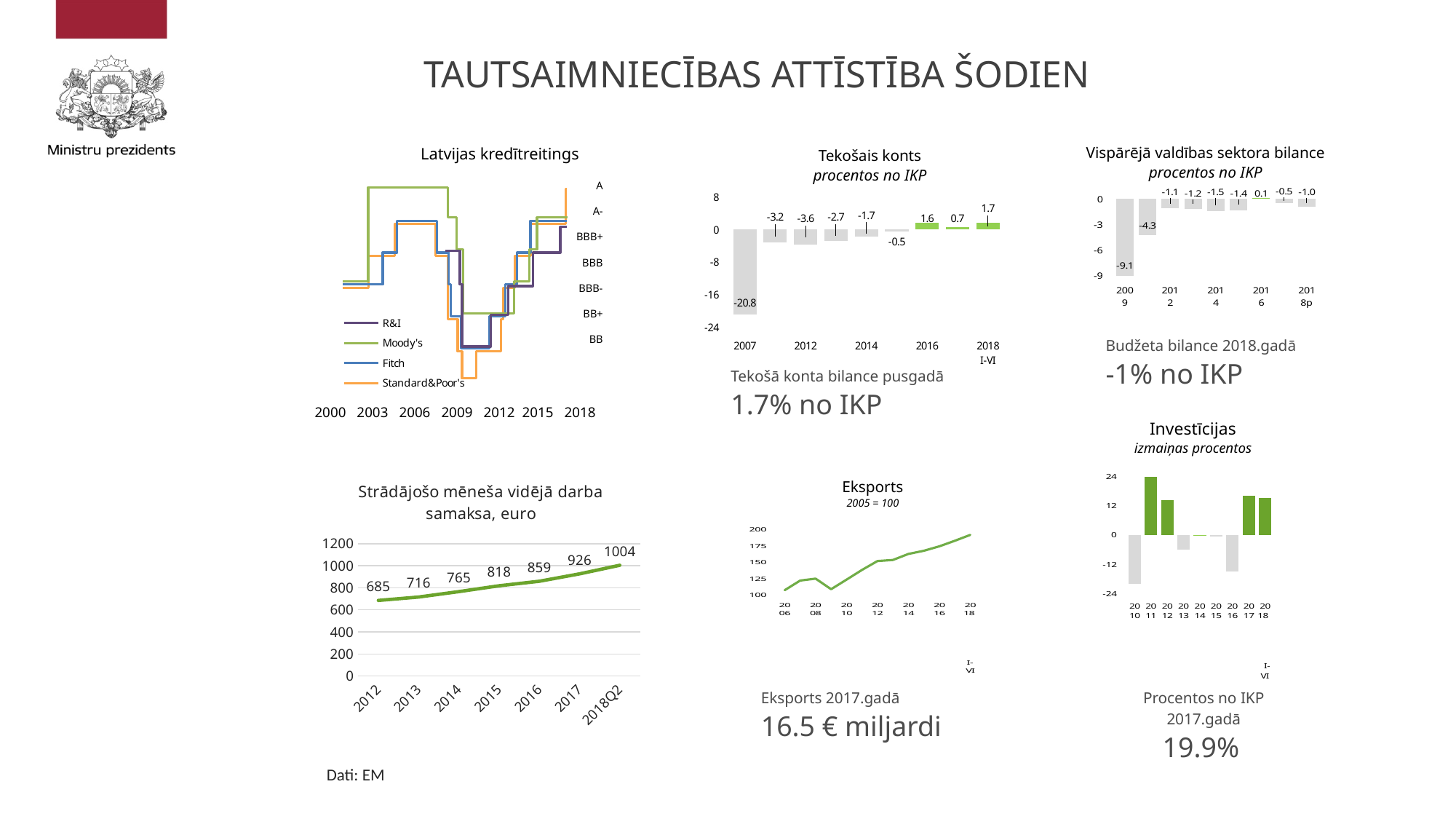
In the 'Vispārējā valdības sektora bilance' chart, what is the value for 2018p? -1.0 In the 'Strādājošo mēneša vidējā darba samaksa, euro' chart, what is the value for 2015? 818 In the 'Tekošais konts' chart, what is the value for 2007? -20.8 In the 'Strādājošo mēneša vidējā darba samaksa, euro' chart, how many data points are plotted? 7 In the 'Eksports' chart, is the value for 2018 greater or less than 175? greater In the 'Vispārējā valdības sektora bilance' chart, what is the value for 2009? -9.1 In the 'Investīcijas' chart, which year has the highest value? 2011 In the 'Strādājošo mēneša vidējā darba samaksa, euro' chart, what is the difference between the 2018Q2 value and the 2012 value? 319 How many series does the legend of the 'Latvijas kredītreitings' chart list? 4 In the 'Tekošais konts' chart, which year has the lowest value? 2007 In the 'Strādājošo mēneša vidējā darba samaksa, euro' chart, do the values rise or fall from 2012 to 2018Q2? rise In the 'Tekošais konts' chart, what is the value for 2018 I-VI? 1.7